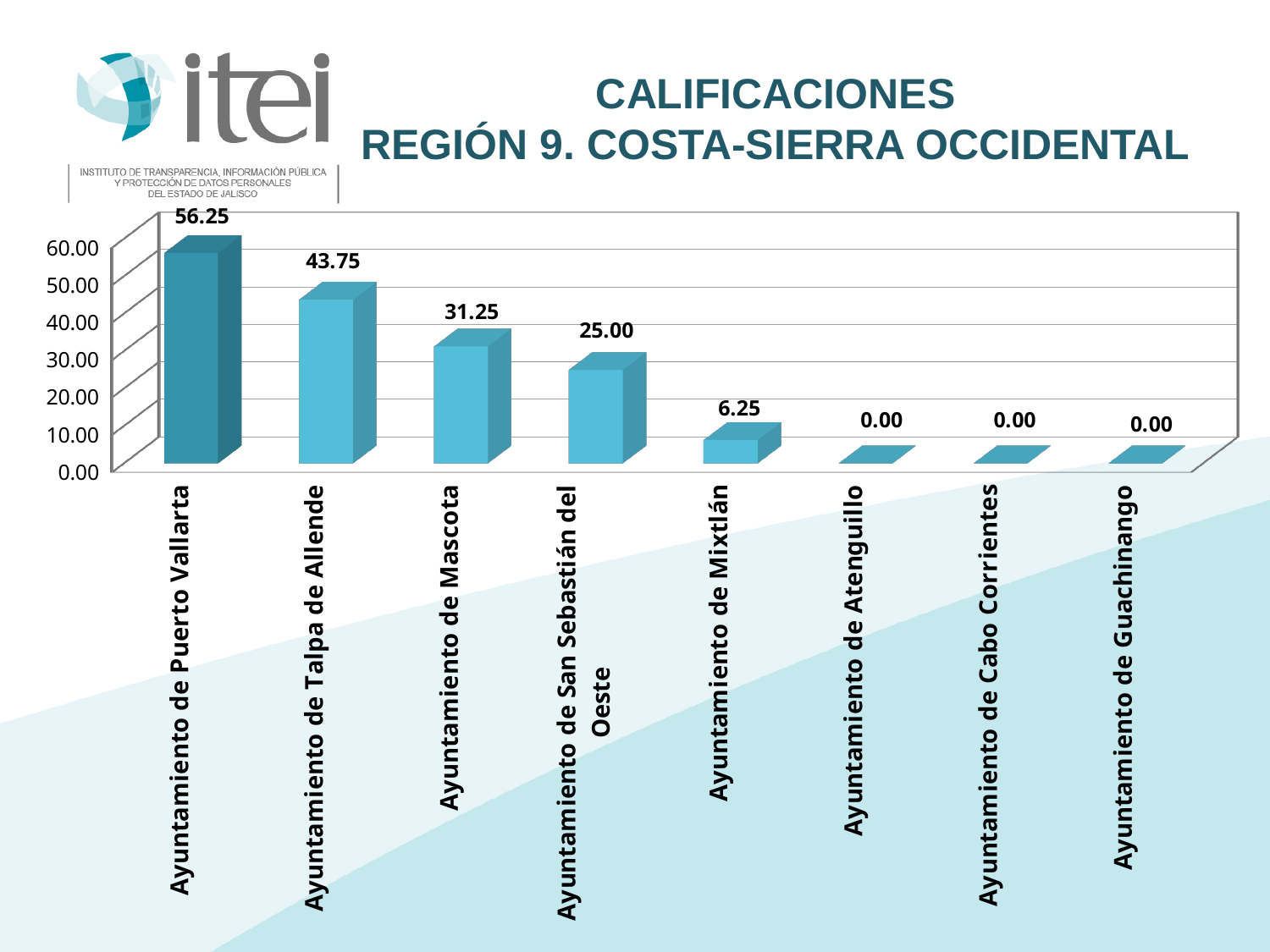
What is the title of the chart? CALIFICACIONES REGIÓN 9. COSTA-SIERRA OCCIDENTAL What is the value for Ayuntamiento de Mixtlán? 6.25 How many categories have a value of 0.00? 3 What kind of chart is shown on the slide? bar chart What is the value for Ayuntamiento de Puerto Vallarta? 56.25 How many categories are shown on the chart? 8 Do the values rise or fall from left to right along the x axis? fall What is the difference between the values for Ayuntamiento de Talpa de Allende and Ayuntamiento de San Sebastián del Oeste? 18.75 What is the value for Ayuntamiento de Cabo Corrientes? 0.00 What is the value for Ayuntamiento de Mascota? 31.25 Which is larger, the value for Ayuntamiento de Mascota or the value for Ayuntamiento de Mixtlán? Ayuntamiento de Mascota Which category has the highest value? Ayuntamiento de Puerto Vallarta